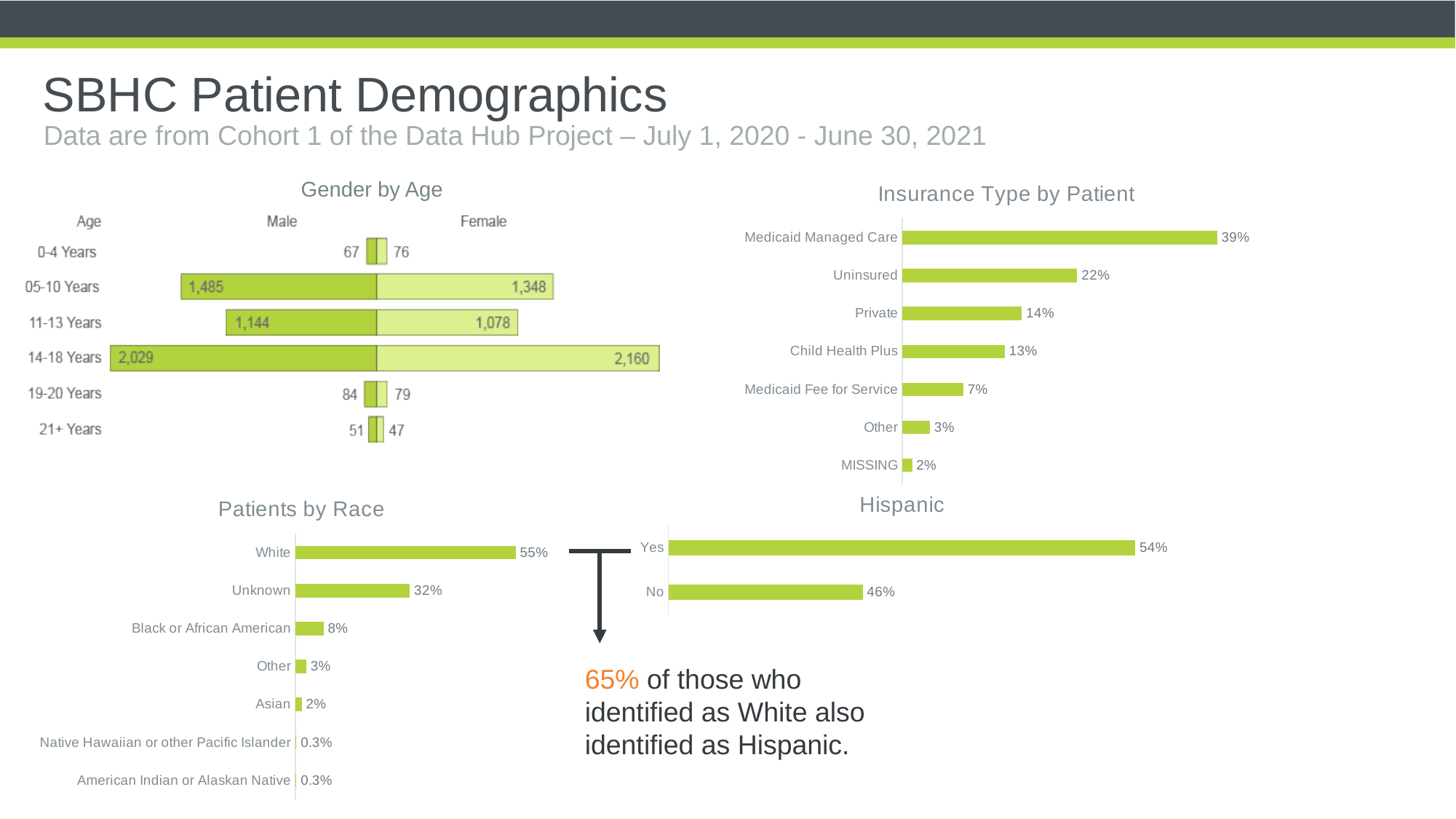
In the Insurance Type by Patient chart, what is the value for Uninsured? 22% In the Patients by Race chart, what is the difference between White and Black or African American? 47% In the Hispanic chart, what is the value for No? 46% In the Gender by Age chart, what is the difference between the Male and Female values for 11-13 Years? 66 What kind of chart is the Patients by Race chart? Bar chart In the Insurance Type by Patient chart, which category has the lowest value? MISSING In the Gender by Age chart, which age group has the highest Female value? 14-18 Years In the Insurance Type by Patient chart, which is larger, Private or Child Health Plus? Private In the Gender by Age chart, what is the Female value for 05-10 Years? 1,348 In the Gender by Age chart, how many age groups are shown? 6 In the Gender by Age chart, what is the Male value for 14-18 Years? 2,029 In the Patients by Race chart, what is the value for Unknown? 32%